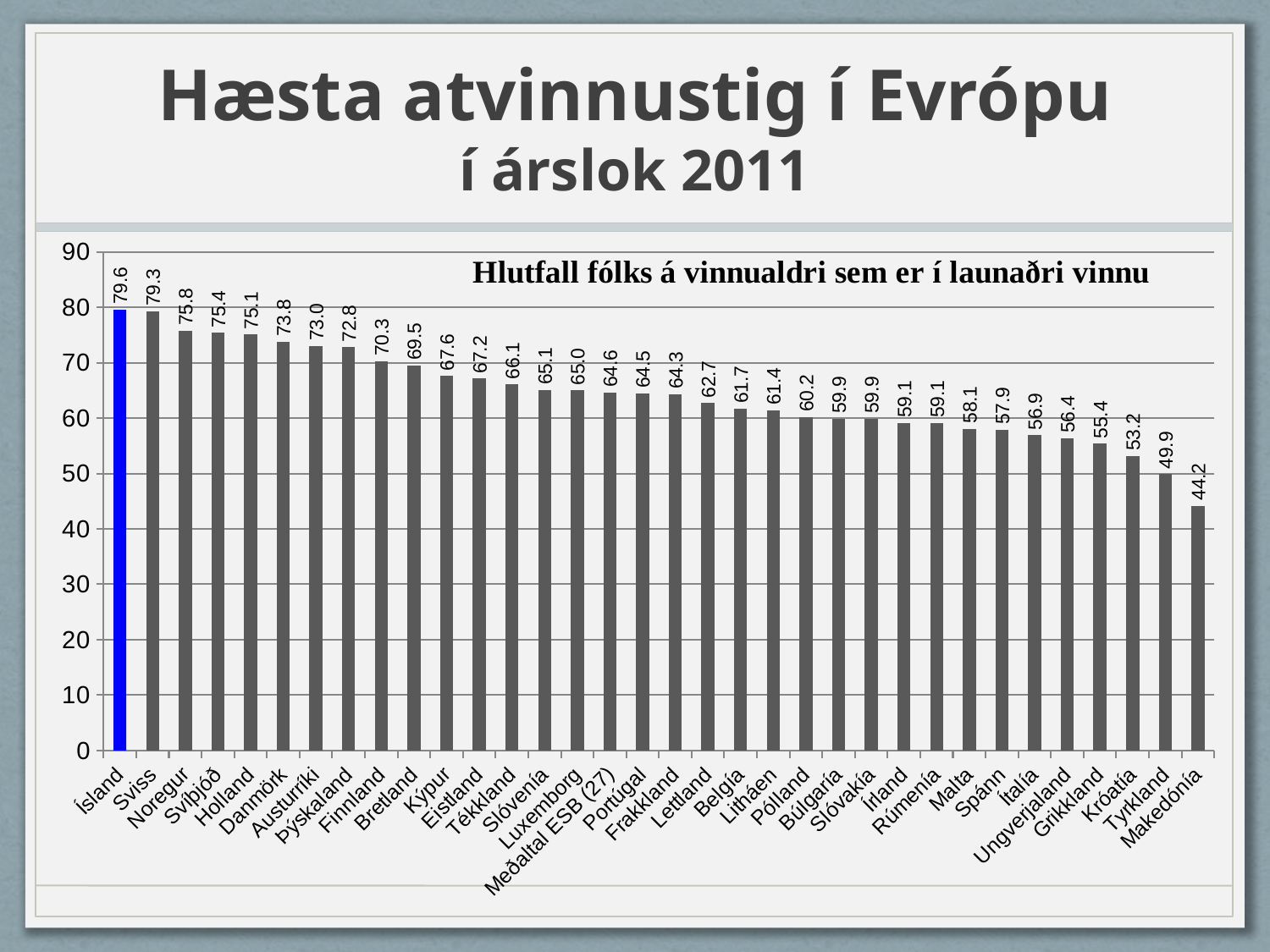
What kind of chart is shown on the slide? Bar chart Which bar is coloured blue instead of grey? Ísland Do the values rise or fall from left to right along the x axis? Fall Which country has the highest value? Ísland How many countries or categories are shown on the chart? 34 What is the difference between the values for Noregur and Svíþjóð? 0.4 What is the value for Tyrkland? 49.9 What is the value for Ísland? 79.6 Which is larger, the value for Finnland or the value for Bretland? Finnland Which country has the lowest value? Makedónía What is the difference between the values for Ísland and Makedónía? 35.4 What is the value for Meðaltal ESB (27)? 64.6